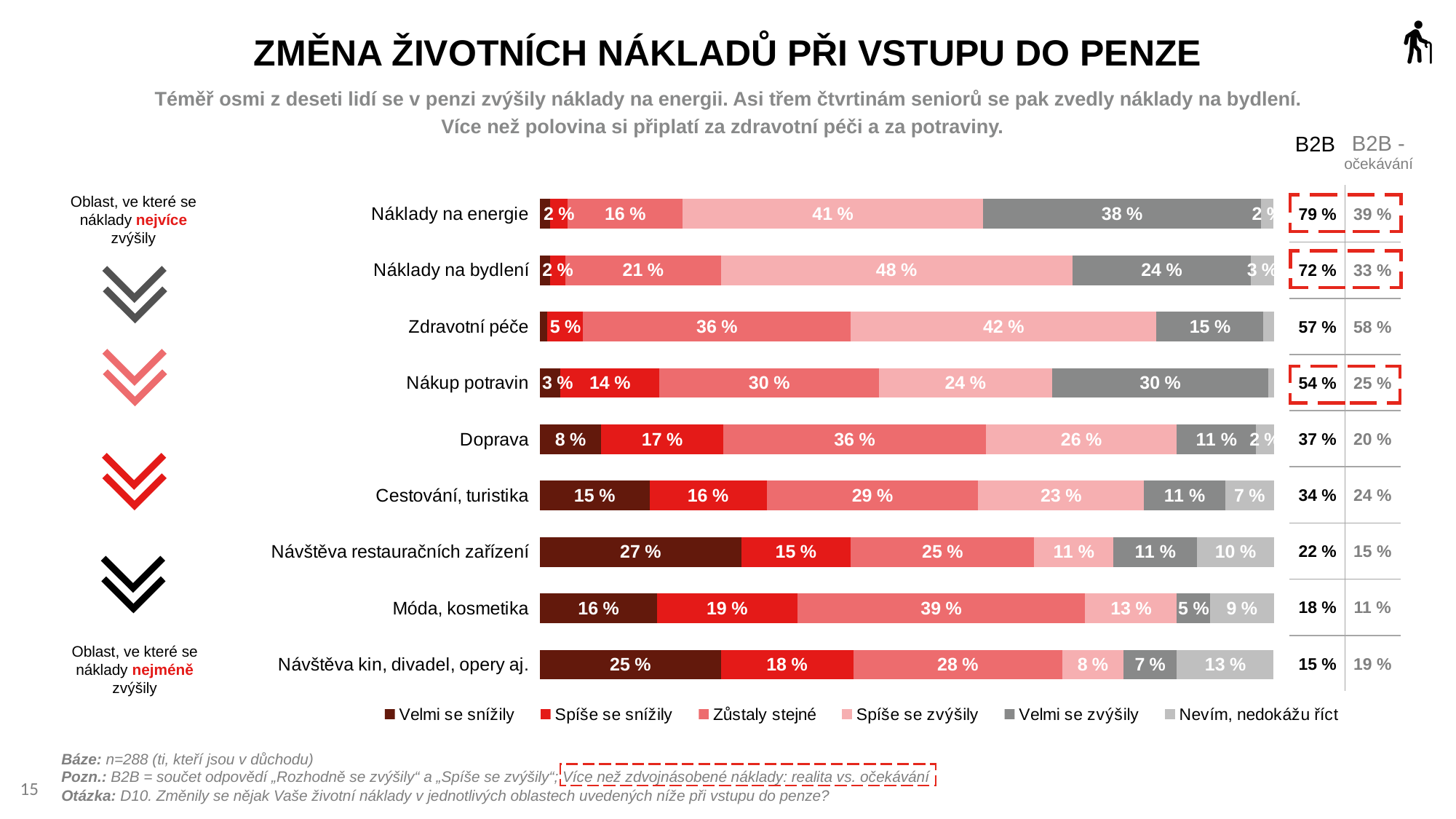
What is the difference between the "Velmi se zvýšily" values for Náklady na energie and Náklady na bydlení? 14 percentage points Which has a larger "Zůstaly stejné" share: Zdravotní péče or Móda, kosmetika? Móda, kosmetika How many categories (areas of expenses) are shown in the chart? 9 What is the "Velmi se snížily" value for Návštěva restauračních zařízení? 27 % What percentage of respondents answered "Spíše se zvýšily" for Náklady na bydlení? 48 % Which category has the lowest "Zůstaly stejné" share? Náklady na energie What is the "Nevím, nedokážu říct" value for Návštěva kin, divadel, opery aj.? 13 % How many series does the legend list? 6 What kind of chart is shown on the slide? Stacked bar chart What is the B2B value for Nákup potravin? 54 % What is the difference between the B2B value and the B2B - očekávání value for Náklady na energie? 40 percentage points Which category has the highest "Velmi se zvýšily" share? Náklady na energie